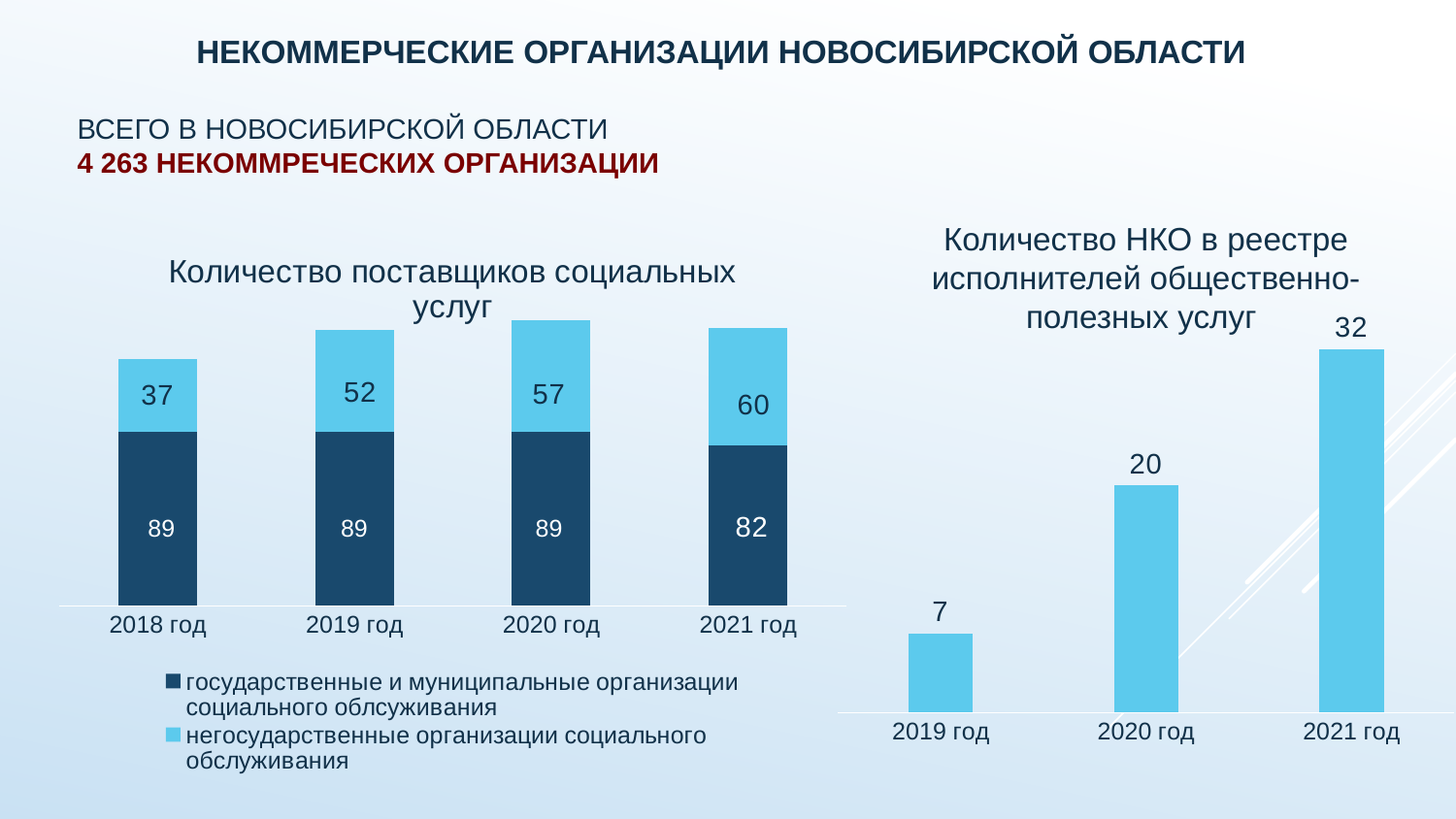
In the chart 'Количество поставщиков социальных услуг', does the value for негосударственные организации социального обслуживания rise or fall from 2018 год to 2021 год? rise In the chart 'Количество поставщиков социальных услуг', what is the value for государственные и муниципальные организации социального обслуживания in 2021 год? 82 In the chart 'Количество поставщиков социальных услуг', how many series does the legend list? 2 In the chart 'Количество поставщиков социальных услуг', what is the value for негосударственные организации социального обслуживания in 2019 год? 52 In the chart 'Количество НКО в реестре исполнителей общественно-полезных услуг', what is the difference between the values for 2021 год and 2019 год? 25 In the chart 'Количество НКО в реестре исполнителей общественно-полезных услуг', what is the value for 2020 год? 20 In the chart 'Количество НКО в реестре исполнителей общественно-полезных услуг', which year has the highest value? 2021 год In the chart 'Количество НКО в реестре исполнителей общественно-полезных услуг', which year has the lowest value? 2019 год In the chart 'Количество поставщиков социальных услуг', what is the difference between the негосударственные value in 2021 год and in 2018 год? 23 In the chart 'Количество поставщиков социальных услуг', what is the total of the stacked bar for 2020 год? 146 In the chart 'Количество поставщиков социальных услуг', how many years are shown on the x axis? 4 What kind of chart is 'Количество НКО в реестре исполнителей общественно-полезных услуг'? bar chart